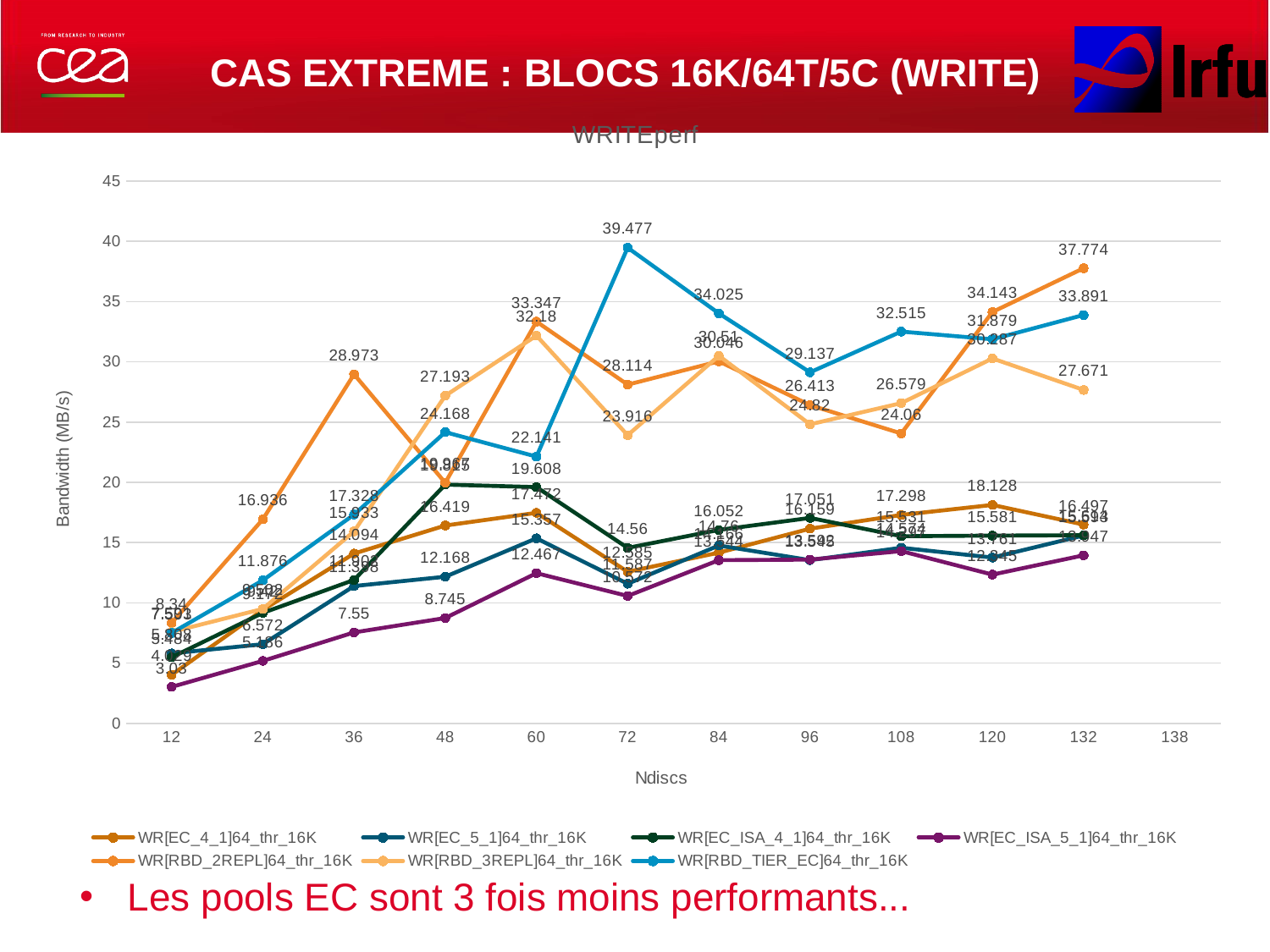
At 72 Ndiscs, which is larger: WR[RBD_TIER_EC]64_thr_16K or WR[RBD_2REPL]64_thr_16K? WR[RBD_TIER_EC]64_thr_16K What is the label of the y axis? Bandwidth (MB/s) What kind of chart is shown on the slide? line chart Does WR[RBD_TIER_EC]64_thr_16K rise or fall between 12 and 72 Ndiscs? rise What is the title of the chart? WRITEperf What is the lowest value plotted on the chart? 3.03 What is the value of WR[RBD_2REPL]64_thr_16K at 132 Ndiscs? 37.774 How many series does the legend of the WRITEperf chart list? 7 What is the value of WR[RBD_TIER_EC]64_thr_16K at 72 Ndiscs? 39.477 What is the value of WR[RBD_2REPL]64_thr_16K at 36 Ndiscs? 28.973 What is the highest value plotted on the chart, and at which Ndiscs value does it occur? 39.477 at 72 What is the difference between WR[RBD_2REPL]64_thr_16K (37.774) and WR[RBD_TIER_EC]64_thr_16K (33.891) at 132 Ndiscs? 3.883